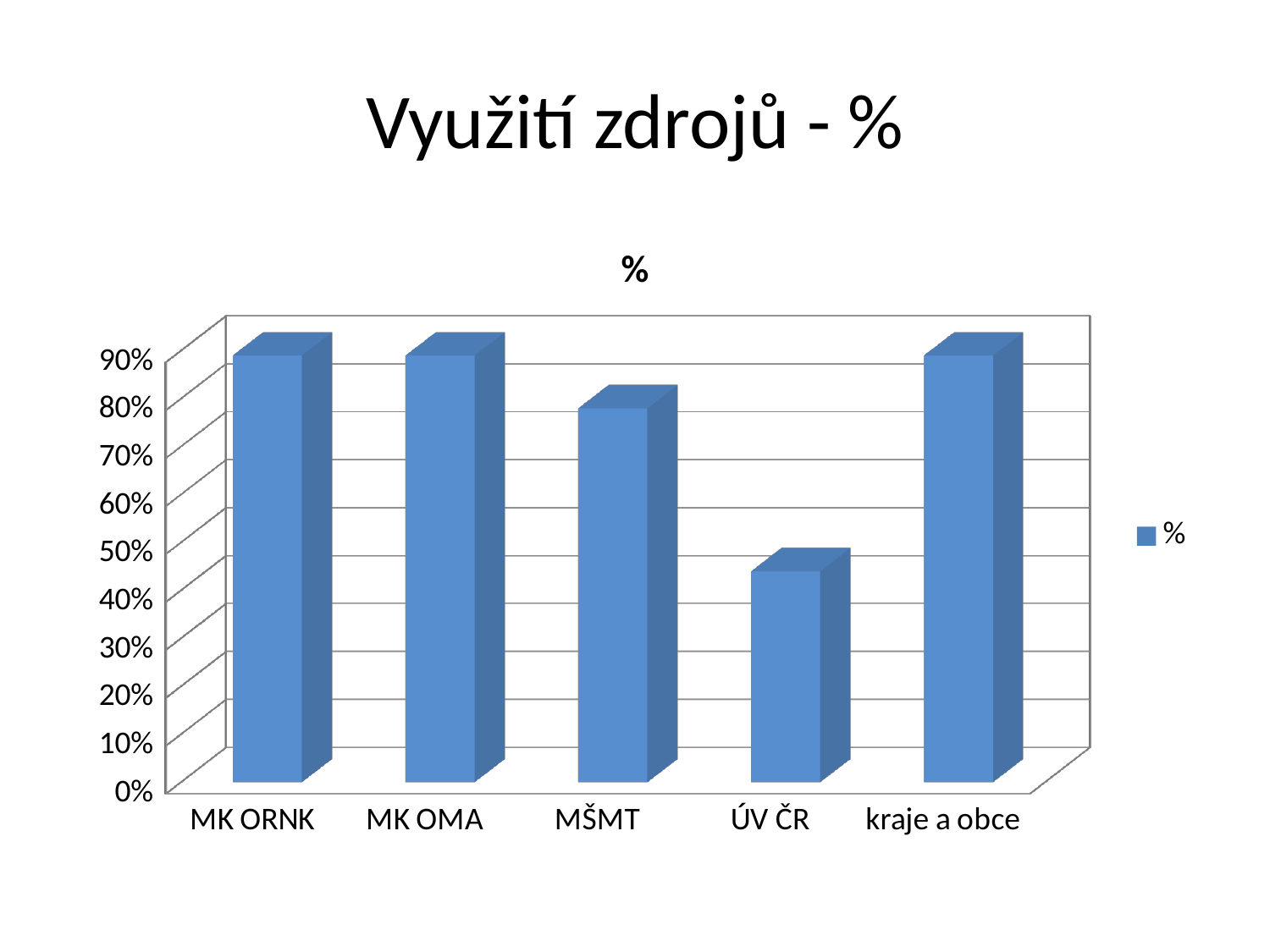
What is the label of the series shown in the legend? % Is the value for ÚV ČR greater or less than 60%? less Is the value for MŠMT greater or less than 70%? greater Is the value for ÚV ČR greater or less than 30%? greater What is the title of the chart? % Which is larger, the value for MŠMT or the value for ÚV ČR? MŠMT How many series does the legend list? 1 What kind of chart is shown on the slide? bar chart Which is larger, the value for MK OMA or the value for MŠMT? MK OMA Which category has the lowest value in the chart? ÚV ČR How many categories are shown on the x axis of the chart? 5